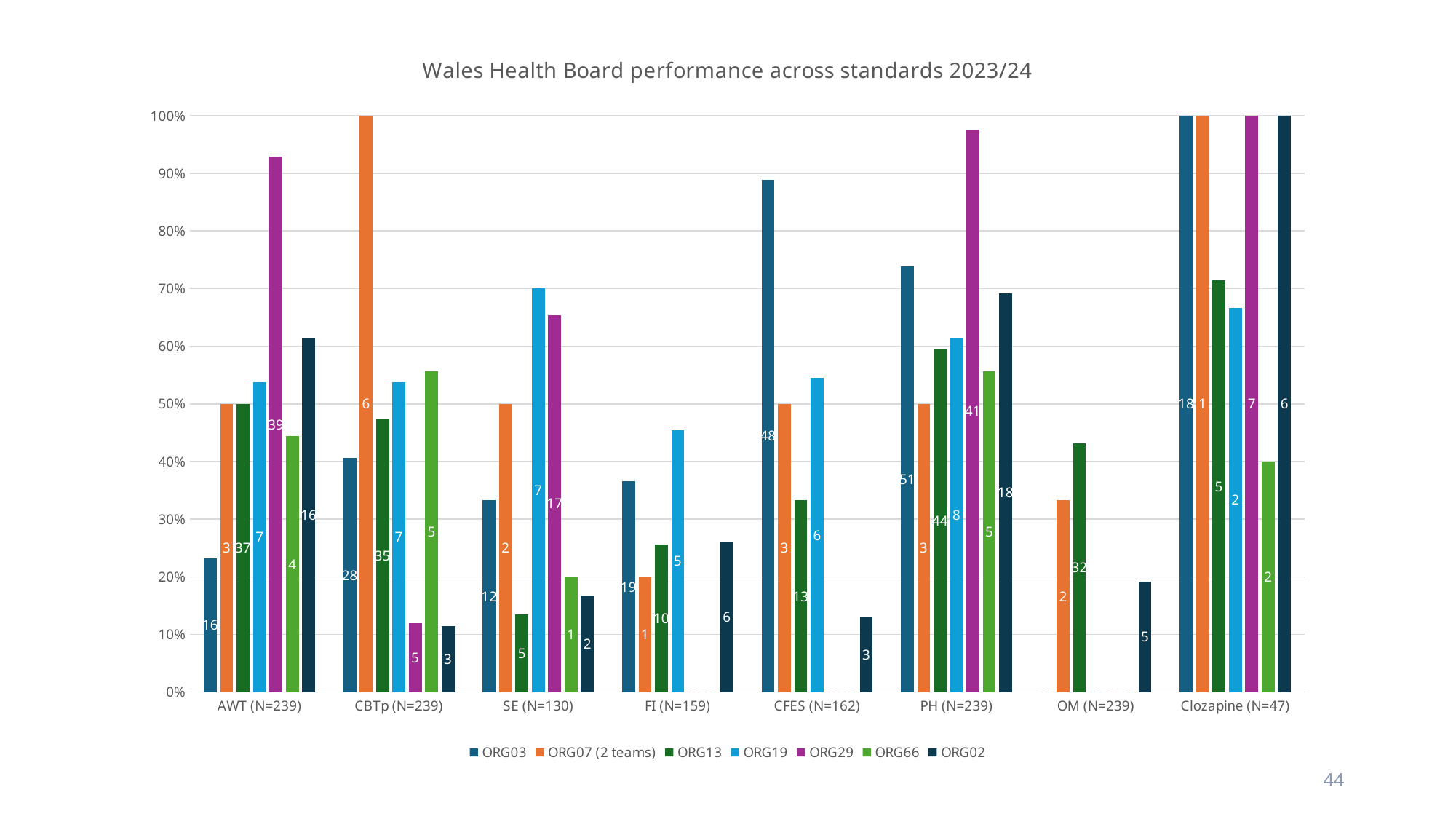
What kind of chart is shown on the slide? bar chart What data label is printed on the ORG03 bar for AWT (N=239)? 16 How many standard categories are shown along the x axis? 8 Which organisation has the highest bar for CBTp (N=239)? ORG07 (2 teams) What is the title of the chart? Wales Health Board performance across standards 2023/24 Which is larger for CBTp (N=239): the ORG66 bar or the ORG13 bar? ORG66 Which organisation has the highest bar for AWT (N=239)? ORG29 How many series does the legend list? 7 Is the value for ORG02 in OM (N=239) greater or less than 20%? less Is the value for ORG29 in PH (N=239) greater or less than 90%? greater Which organisation has the highest bar for CFES (N=162)? ORG03 Which organisation has the lowest bar for AWT (N=239)? ORG03